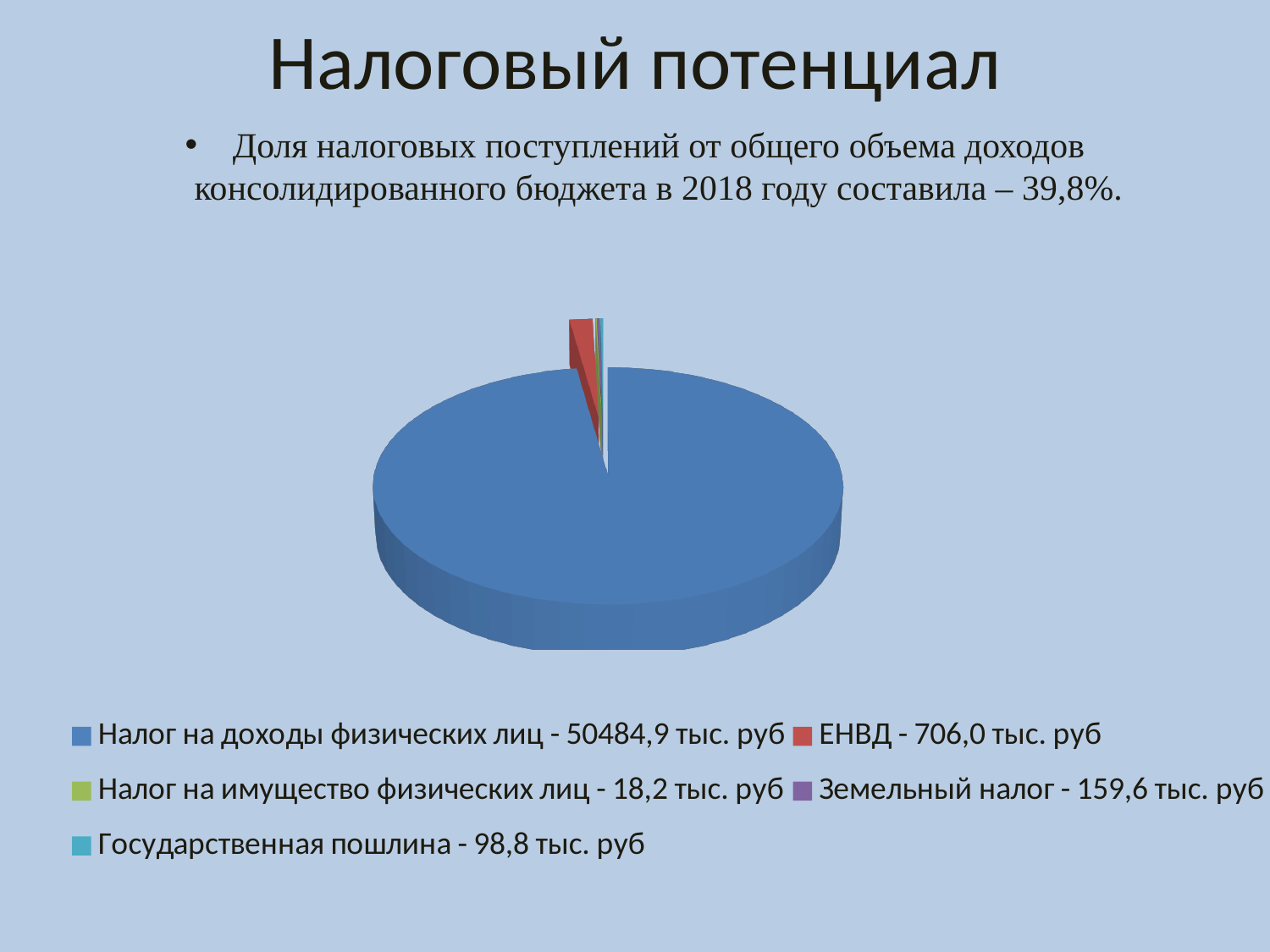
What is the difference between the values for ЕНВД and Земельный налог? 546,4 тыс. руб Which category has the largest value in the pie chart? Налог на доходы физических лиц Which category has the smallest value in the pie chart? Налог на имущество физических лиц What is the value for Государственная пошлина? 98,8 тыс. руб What kind of chart is shown on the slide? Pie chart What is the value for ЕНВД? 706,0 тыс. руб What is the value for Земельный налог? 159,6 тыс. руб Which is larger, the value for Земельный налог or the value for Государственная пошлина? Земельный налог What colour is the slice for Налог на доходы физических лиц? Blue How many categories does the pie chart's legend list? 5 What is the value for Налог на доходы физических лиц? 50484,9 тыс. руб What is the total of all the values listed in the pie chart's legend? 51467,5 тыс. руб